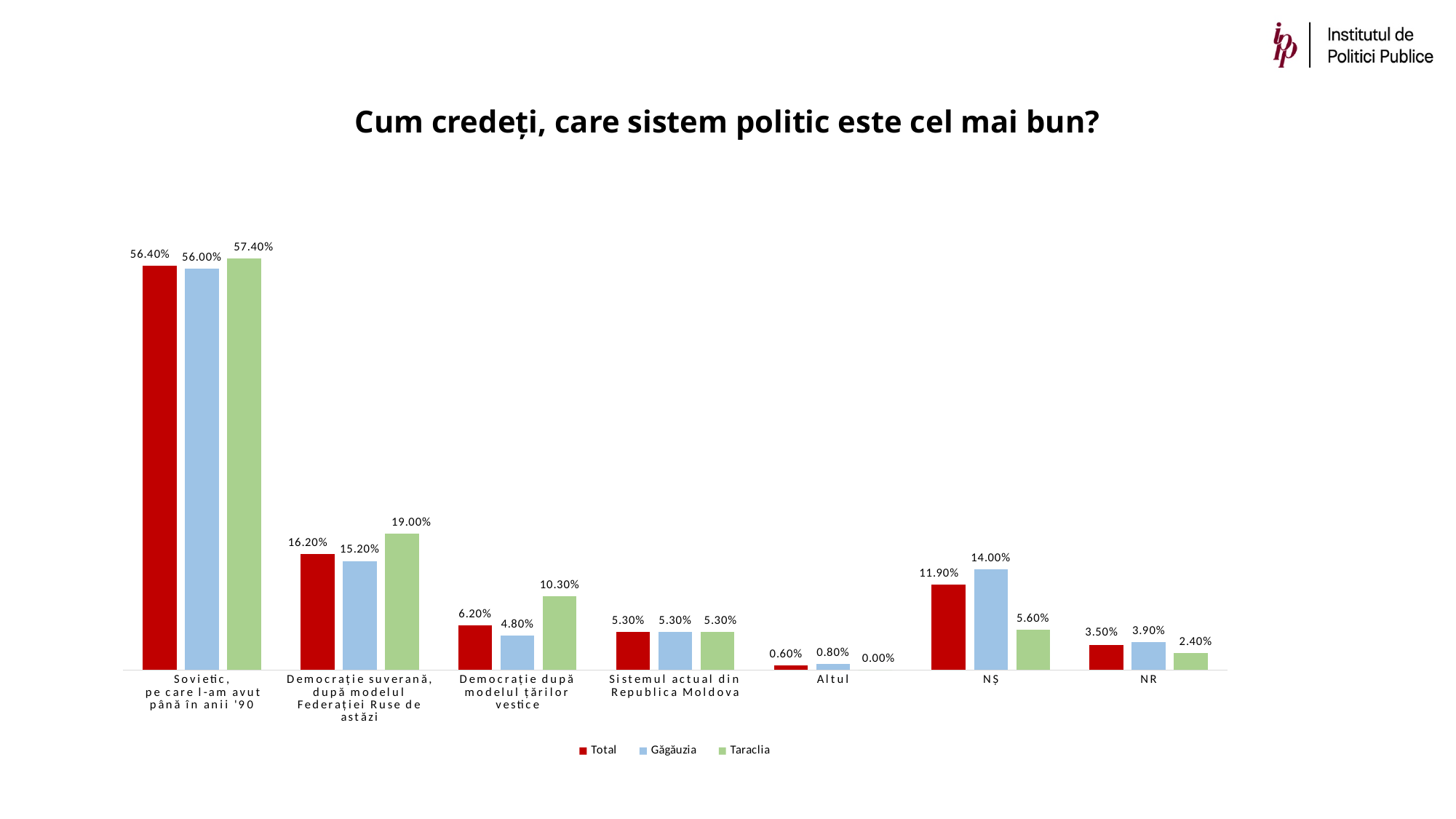
What kind of chart is shown on the slide? Bar chart How many categories are shown on the x axis? 7 What is the Taraclia value for 'Altul'? 0.00% For 'NȘ', which is larger: the Total value or the Taraclia value? Total How many series does the legend list? 3 What is the title of the chart? Cum credeți, care sistem politic este cel mai bun? What is the Taraclia value for 'Democrație suverană, după modelul Federației Ruse de astăzi'? 19.00% What is the Total value for the 'Sovietic, pe care l-am avut până în anii '90' category? 56.40% Which category has the highest Total value? Sovietic, pe care l-am avut până în anii '90 Which category has the lowest Găgăuzia value? Altul What is the difference between the Taraclia and Găgăuzia values for 'Democrație după modelul țărilor vestice'? 5.50% What is the Găgăuzia value for 'NȘ'? 14.00%